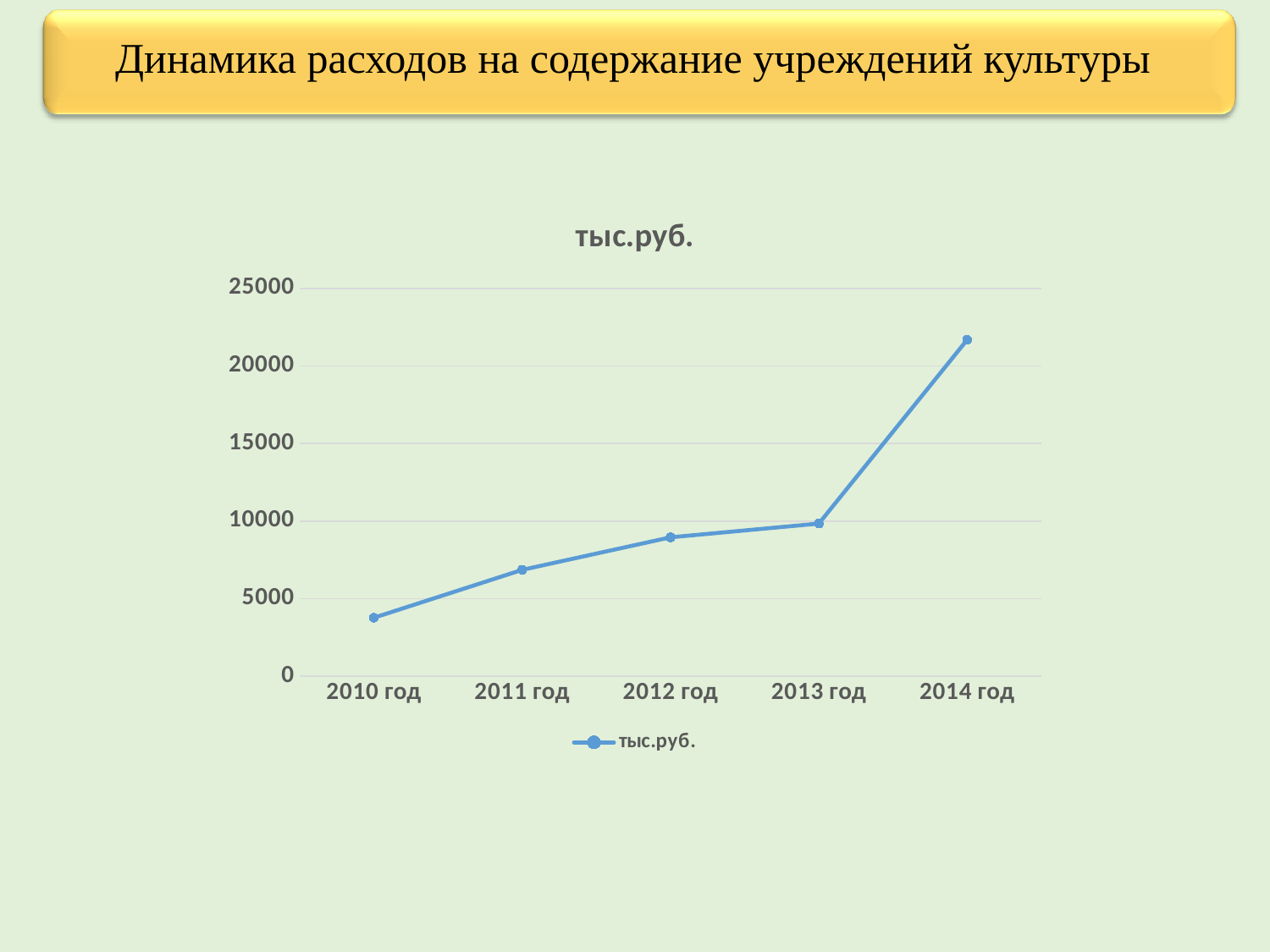
Is the value for 2010 год greater or less than 5000? less How many series does the legend list? 1 How many years are plotted on the x axis? 5 Do the values rise or fall from 2010 год to 2014 год? rise Is the value for 2012 год greater or less than 10000? less Which year has the highest value? 2014 год What is the title of the chart? тыс.руб. Which year has the lowest value? 2010 год Is the value for 2011 год greater or less than 5000? greater Which is larger, the value for 2013 год or the value for 2014 год? 2014 год What kind of chart is shown on the slide? line chart